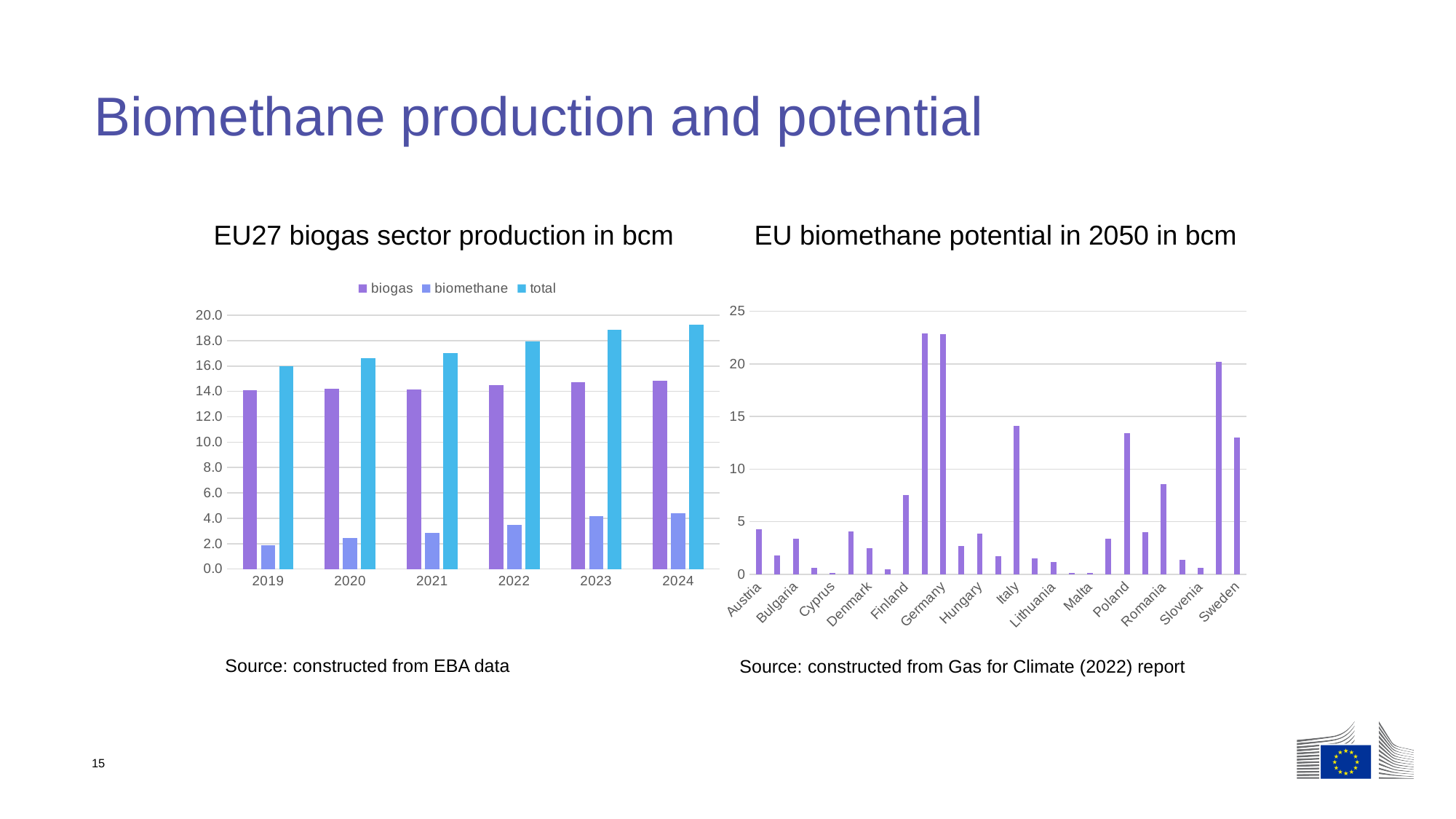
How many years are shown on the x axis of the 'EU27 biogas sector production in bcm' chart? 6 In the 'EU biomethane potential in 2050 in bcm' chart, is the value for Finland greater or less than 10? less In the 'EU biomethane potential in 2050 in bcm' chart, is the value for Germany greater or less than 20? greater In the 'EU27 biogas sector production in bcm' chart, is the biogas value for 2019 greater or less than 16.0? less In the 'EU27 biogas sector production in bcm' chart, which year has the highest total value? 2024 What kind of chart is the 'EU27 biogas sector production in bcm' chart? bar chart In the 'EU27 biogas sector production in bcm' chart, which is larger: the biomethane value for 2024 or the biomethane value for 2019? 2024 In the 'EU biomethane potential in 2050 in bcm' chart, which is larger: the value for Sweden or the value for Austria? Sweden In the 'EU27 biogas sector production in bcm' chart, does the total series rise or fall from 2019 to 2024? rise How many series does the legend of the 'EU27 biogas sector production in bcm' chart list? 3